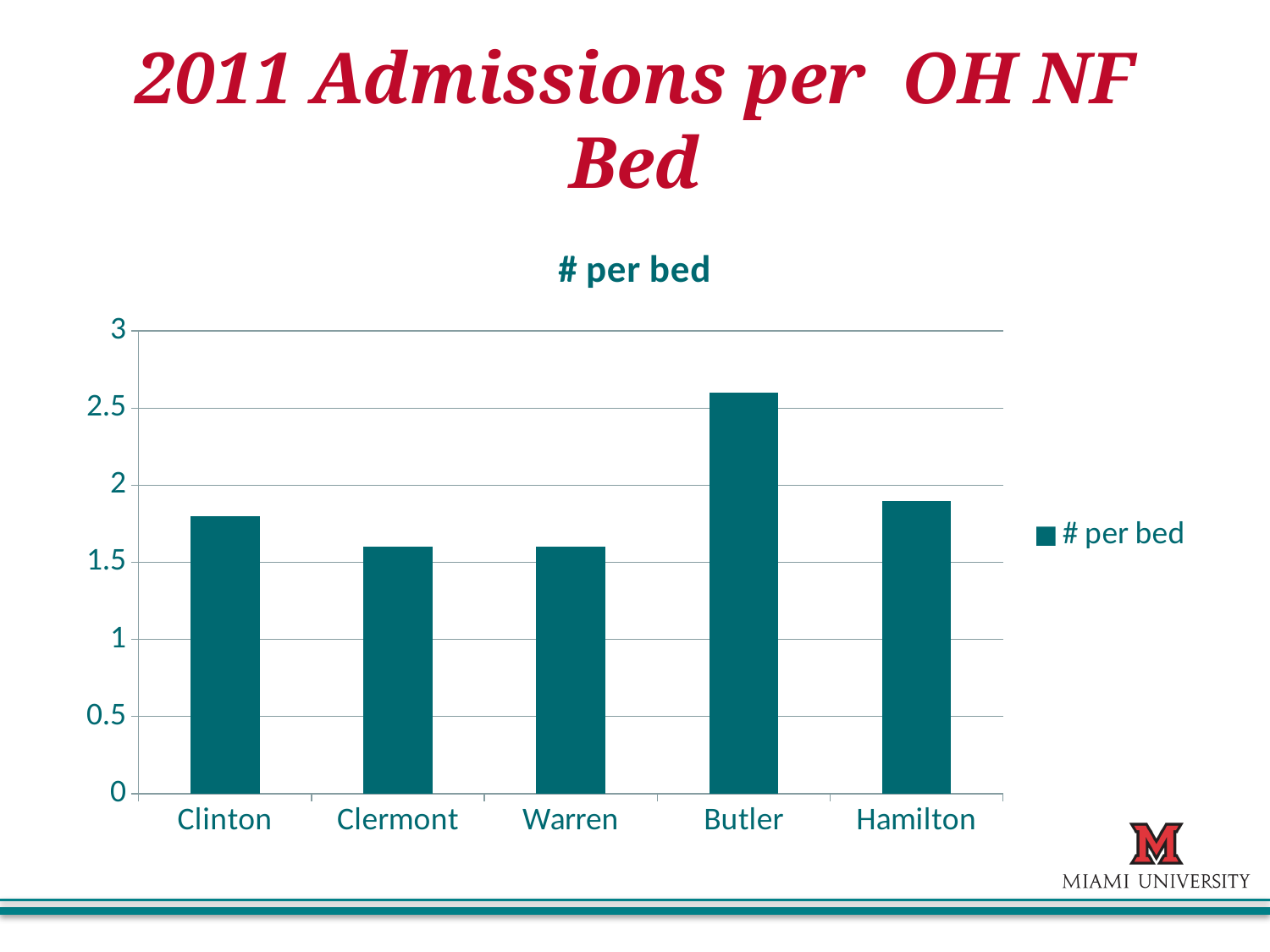
How many series does the chart's legend list? 1 Which is larger, the value for Butler or the value for Clinton? Butler Which county has the highest value in the # per bed chart? Butler How many counties are shown on the x axis of the chart? 5 Is the value for Butler greater or less than 2.5? greater Is the value for Hamilton greater or less than 1.5? greater Which is larger, the value for Hamilton or the value for Clermont? Hamilton Is the value for Clermont greater or less than 1.5? greater What is the title shown above the chart? # per bed What kind of chart is shown on the slide? bar chart